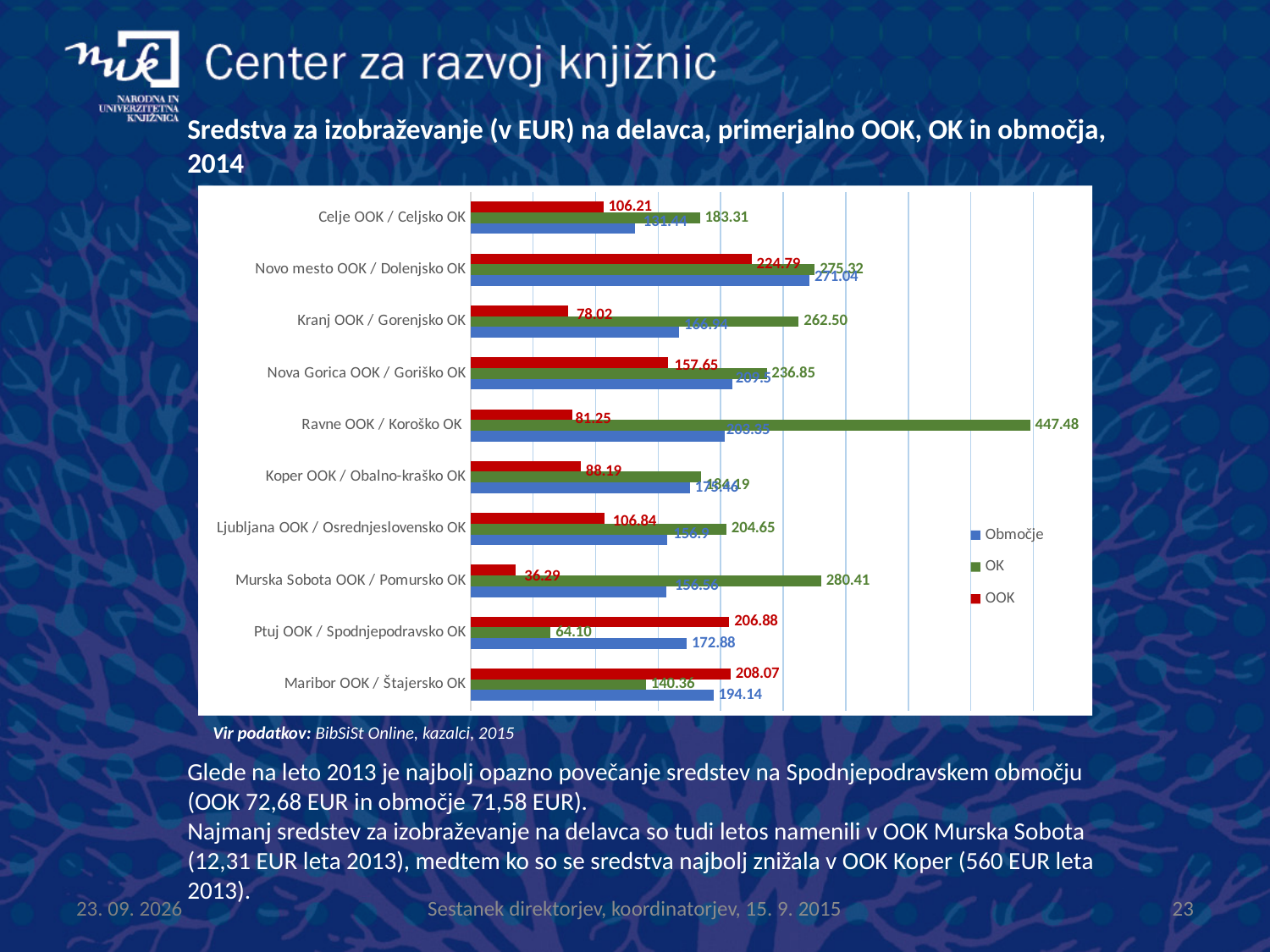
What is the difference between the OK and OOK values for Novo mesto OOK / Dolenjsko OK? 50.53 What is the difference between the OOK and OK values for Ptuj OOK / Spodnjepodravsko OK? 142.78 What is the OK value for Ravne OOK / Koroško OK? 447.48 How many categories are shown on the chart? 10 What kind of chart is shown on the slide? Bar chart For Kranj OOK / Gorenjsko OK, which is larger: the OK value or the OOK value? OK How many series does the legend list? 3 What is the Območje value for Maribor OOK / Štajersko OK? 194.14 Which category has the lowest OOK value? Murska Sobota OOK / Pomursko OK What is the OOK value for Murska Sobota OOK / Pomursko OK? 36.29 What is the OK value for Ptuj OOK / Spodnjepodravsko OK? 64.10 Which category has the highest OK value? Ravne OOK / Koroško OK